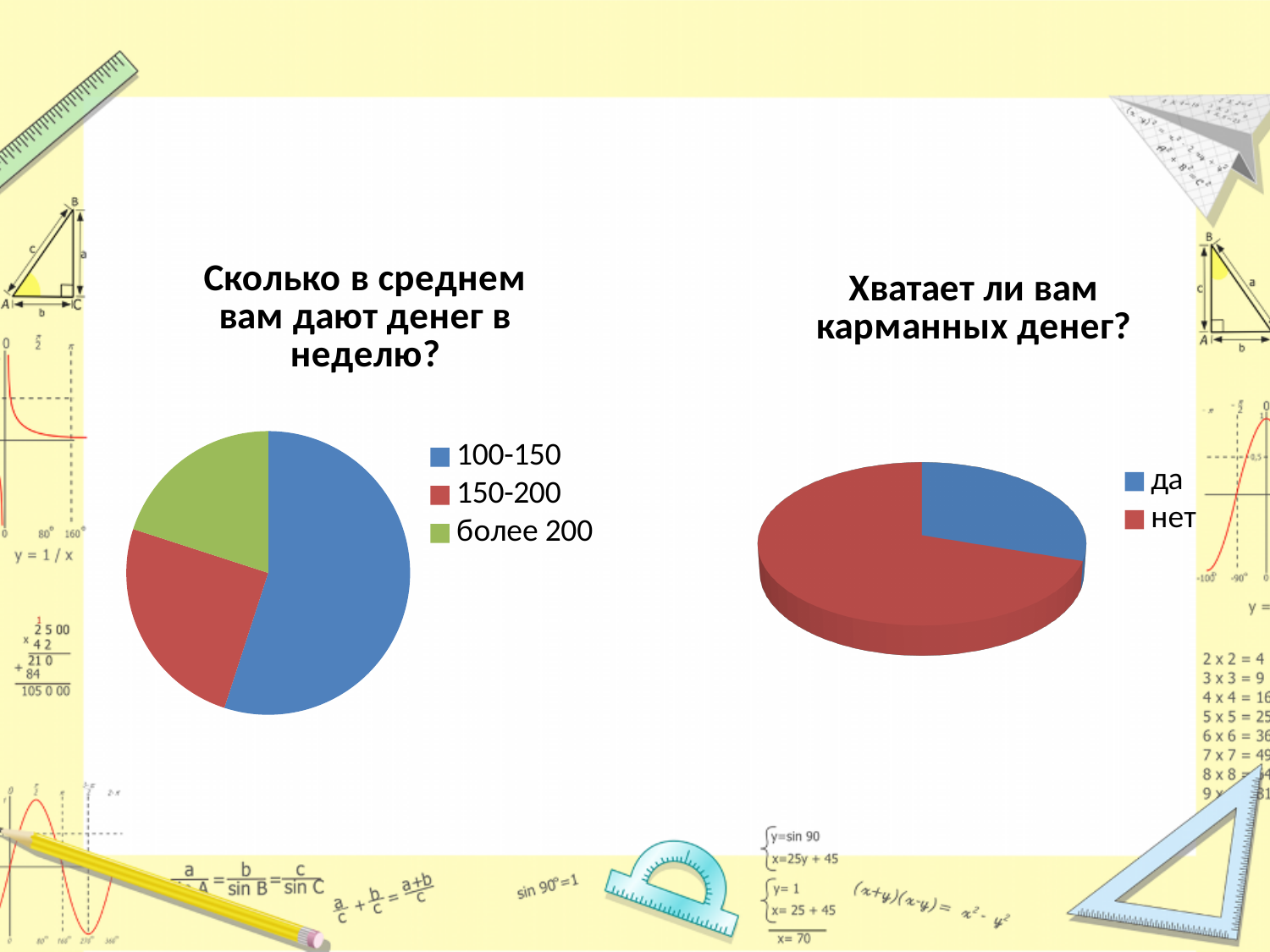
In the right chart "Хватает ли вам карманных денег?", which answer has the smallest slice? да In the left chart "Сколько в среднем вам дают денег в неделю?", which slice is larger: 150-200 or более 200? 150-200 What is the title of the right chart on the slide? Хватает ли вам карманных денег? What kind of chart is the left chart titled "Сколько в среднем вам дают денег в неделю?"? pie chart In the left chart "Сколько в среднем вам дают денег в неделю?", which category has the smallest slice? более 200 In the left chart "Сколько в среднем вам дают денег в неделю?", what colour is the slice for более 200? green In the left chart "Сколько в среднем вам дают денег в неделю?", which category has the largest slice? 100-150 In the left chart "Сколько в среднем вам дают денег в неделю?", how many slices does the pie have? 3 In the right chart "Хватает ли вам карманных денег?", which answer has the largest slice? нет In the right chart "Хватает ли вам карманных денег?", how many slices does the pie have? 2 What kind of chart is the right chart titled "Хватает ли вам карманных денег?"? pie chart In the right chart "Хватает ли вам карманных денег?", which slice is larger: да or нет? нет